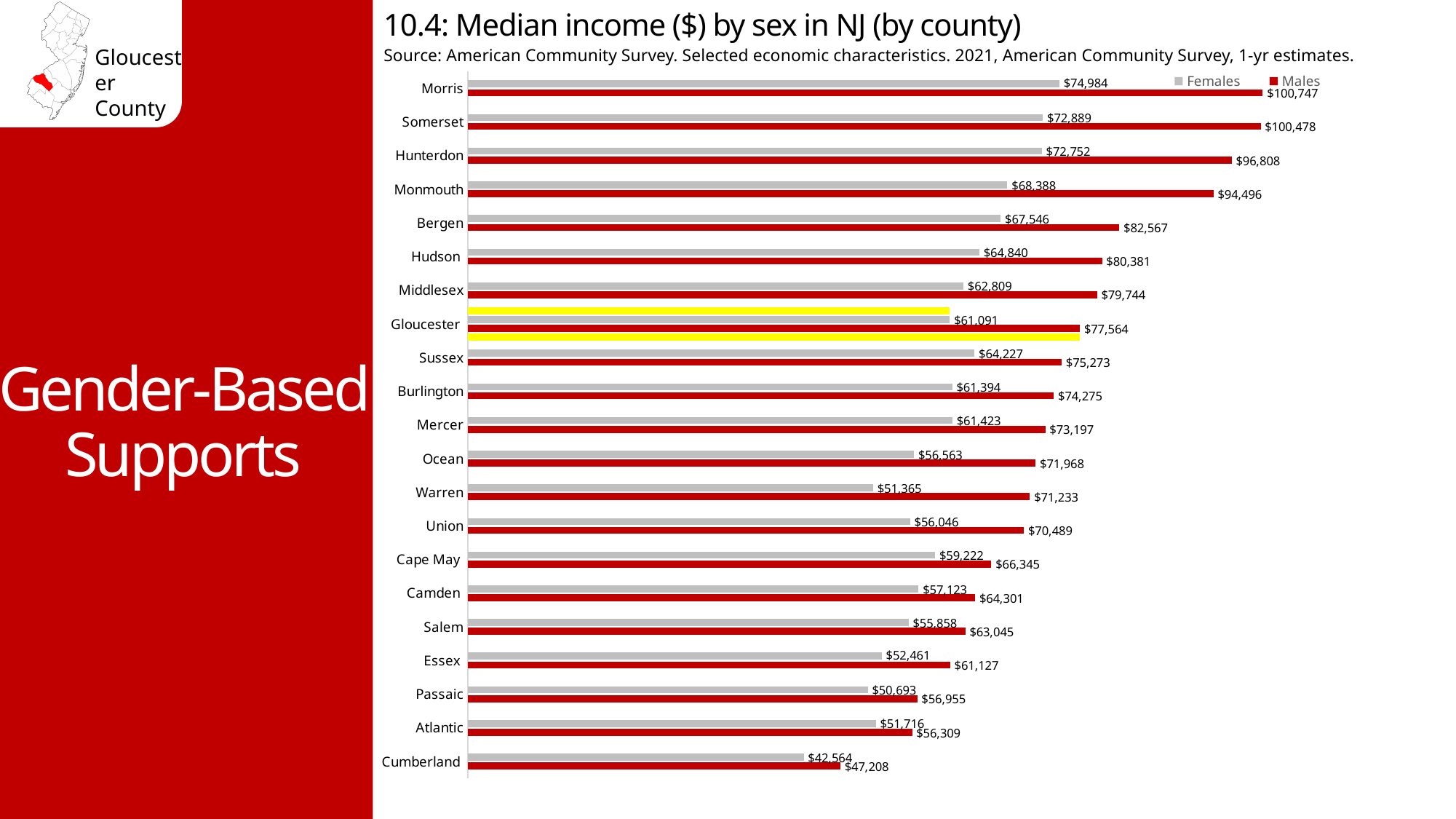
How many series does the legend list? 2 How many counties are shown on the chart? 21 What is the median income for females in Gloucester County? $61,091 What type of chart is shown on the slide? Bar chart What is the median income for females in Morris County? $74,984 Which county's bars are highlighted in yellow on the chart? Gloucester Which county has the lowest median income for females? Cumberland Which is larger: the female median income in Sussex County or in Gloucester County? Sussex County What is the median income for males in Cumberland County? $47,208 What is the median income for males in Gloucester County? $77,564 What is the difference between male and female median income in Gloucester County? $16,473 Which county has the highest median income for males? Morris